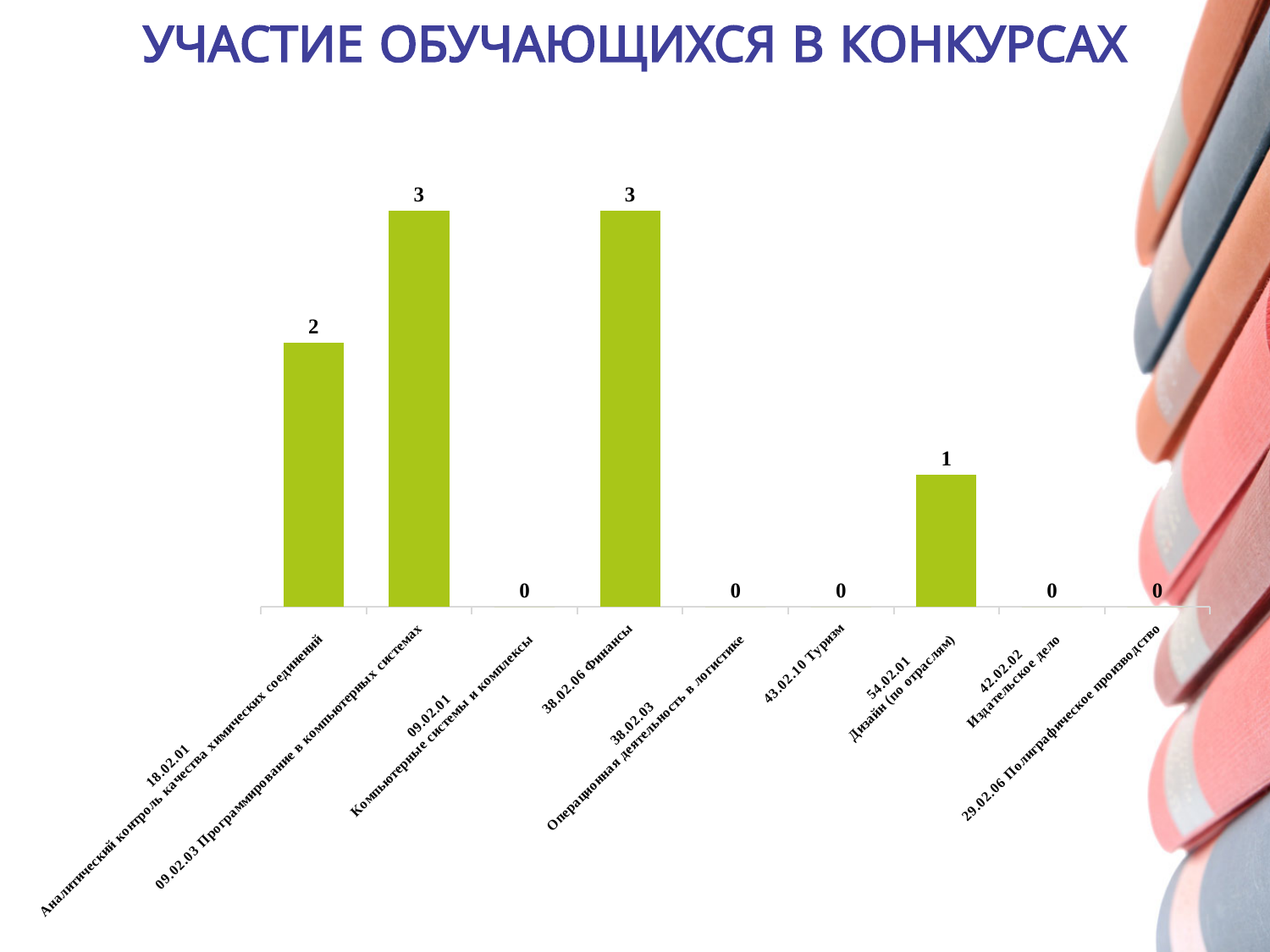
What is the difference between the values for 38.02.06 Финансы and 18.02.01 Аналитический контроль качества химических соединений? 1 What is the value for 43.02.10 Туризм? 0 What is the value for 18.02.01 Аналитический контроль качества химических соединений? 2 What is the difference between the values for 09.02.03 Программирование в компьютерных системах and 54.02.01 Дизайн (по отраслям)? 2 What is the value for 09.02.03 Программирование в компьютерных системах? 3 What is the value for 54.02.01 Дизайн (по отраслям)? 1 What is the value for 38.02.06 Финансы? 3 What kind of chart is shown on the slide? Bar chart What is the title of the slide? УЧАСТИЕ ОБУЧАЮЩИХСЯ В КОНКУРСАХ Which has a larger value: 18.02.01 Аналитический контроль качества химических соединений or 54.02.01 Дизайн (по отраслям)? 18.02.01 Аналитический контроль качества химических соединений What is the value for 29.02.06 Полиграфическое производство? 0 How many categories are shown on the x axis of the chart? 9